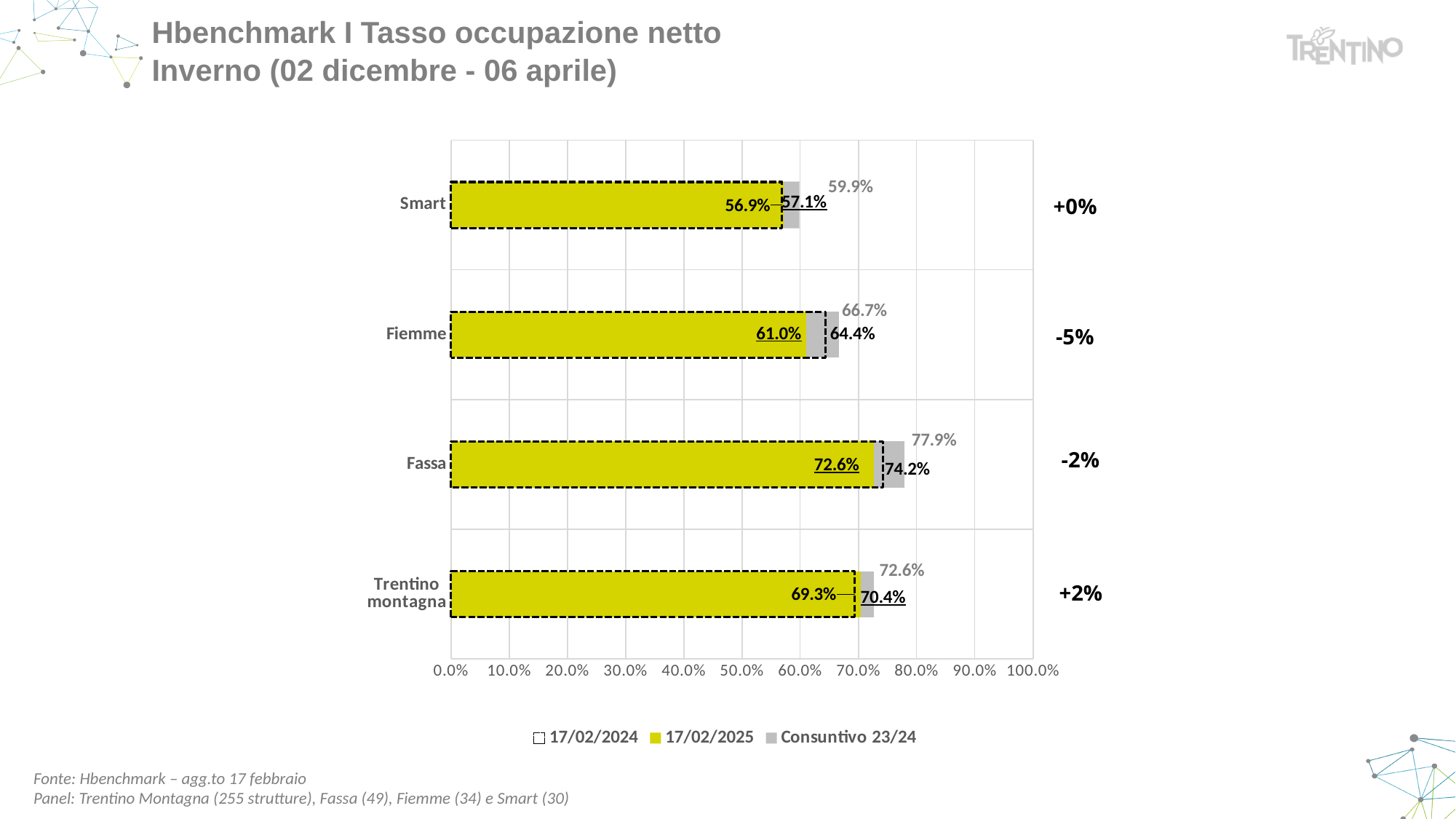
How many categories are plotted on the chart? 4 How many series does the legend list? 3 What is the Consuntivo 23/24 value for Fassa? 77.9% What type of chart is shown on the slide? Bar chart Which category has the lowest Consuntivo 23/24 value? Smart What is the Consuntivo 23/24 value for Smart? 59.9% What is the difference between the Consuntivo 23/24 values for Fassa and Fiemme? 11.2 percentage points What is the 17/02/2025 value for Fiemme? 61.0% What percentage change is shown to the right of the chart for Fiemme? -5% What is the 17/02/2024 value for Fassa? 74.2% Which is larger, the 17/02/2025 value for Fassa or for Fiemme? Fassa Which category has the highest Consuntivo 23/24 value? Fassa